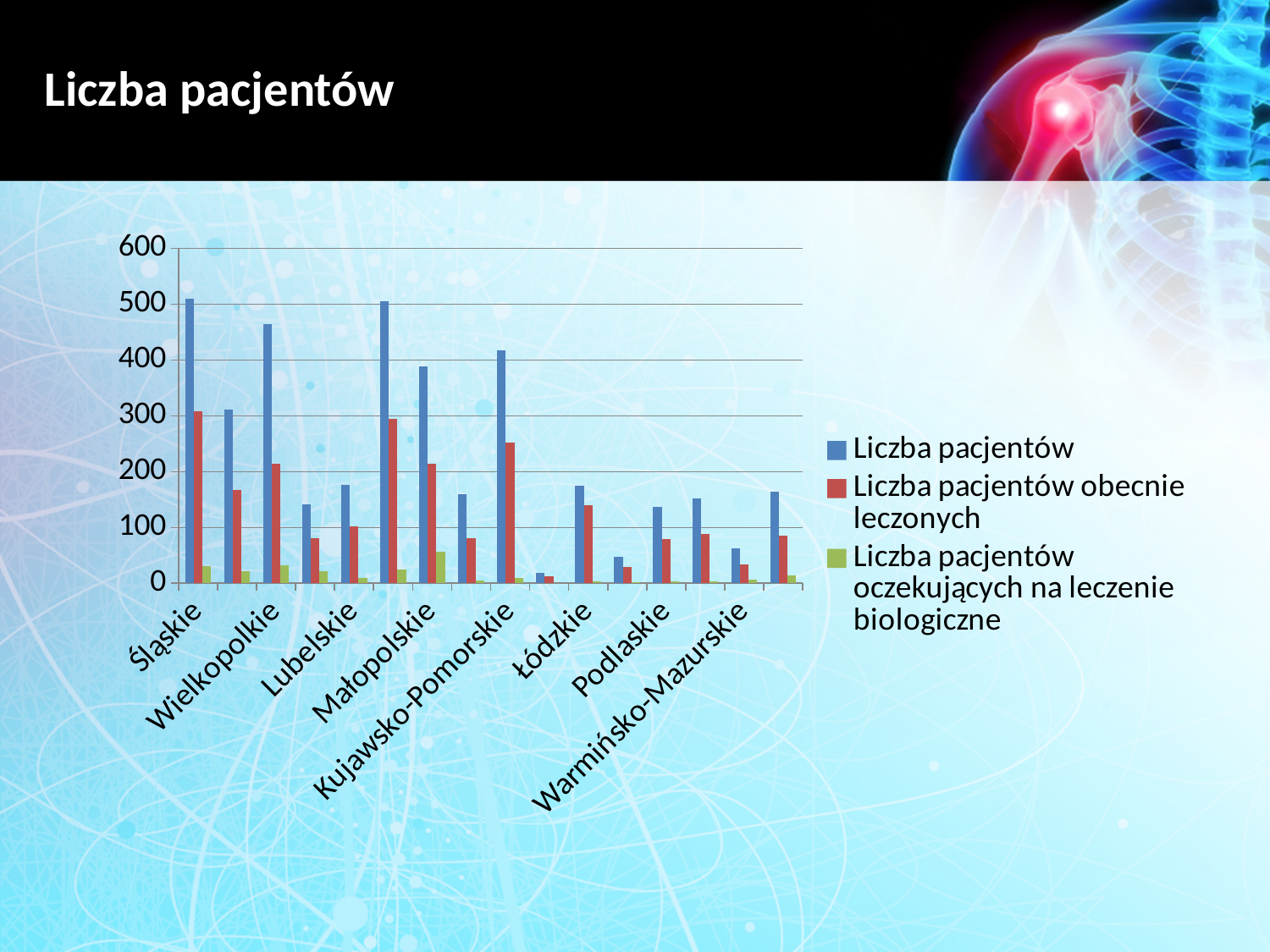
Which has a higher value of Liczba pacjentów, Śląskie or Wielkopolskie? Śląskie Is the value of Liczba pacjentów for Warmińsko-Mazurskie greater or less than 100? less What is the title of the slide containing the chart? Liczba pacjentów Is the value of Liczba pacjentów for Kujawsko-Pomorskie greater or less than 300? greater Is the value of Liczba pacjentów for Śląskie greater or less than 400? greater How many series does the legend list? 3 What kind of chart is shown on the slide? bar chart Which has a higher value of Liczba pacjentów obecnie leczonych, Łódzkie or Podlaskie? Łódzkie Which series is shown in green in the legend? Liczba pacjentów oczekujących na leczenie biologiczne